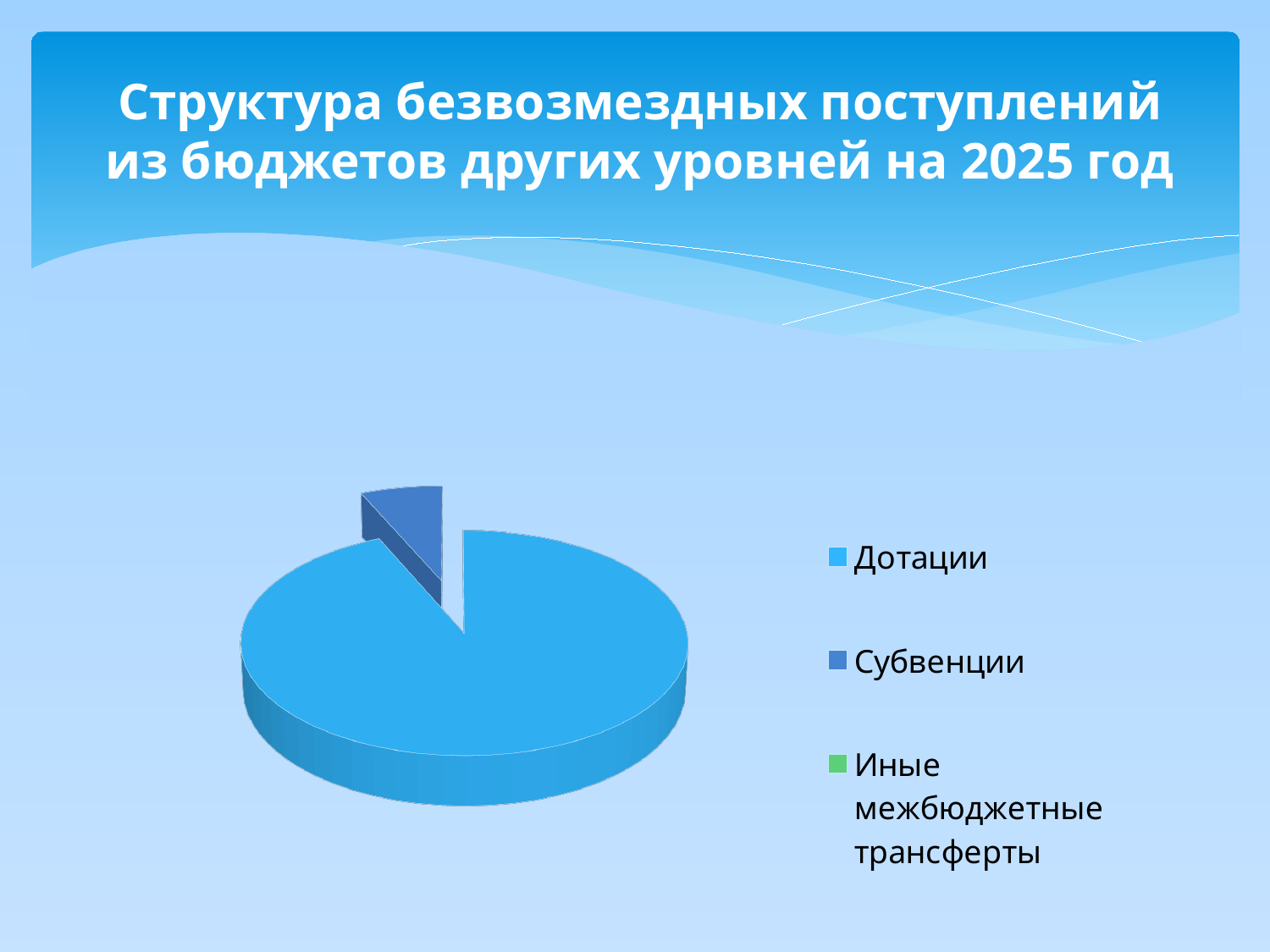
What is the title of the chart slide? Структура безвозмездных поступлений из бюджетов других уровней на 2025 год What kind of chart is shown on the slide? pie chart Which category has the largest slice of the pie chart? Дотации Which legend entry is shown in green? Иные межбюджетные трансферты How many entries does the legend of the pie chart list? 3 Which is larger in the pie chart, Дотации or Субвенции? Дотации